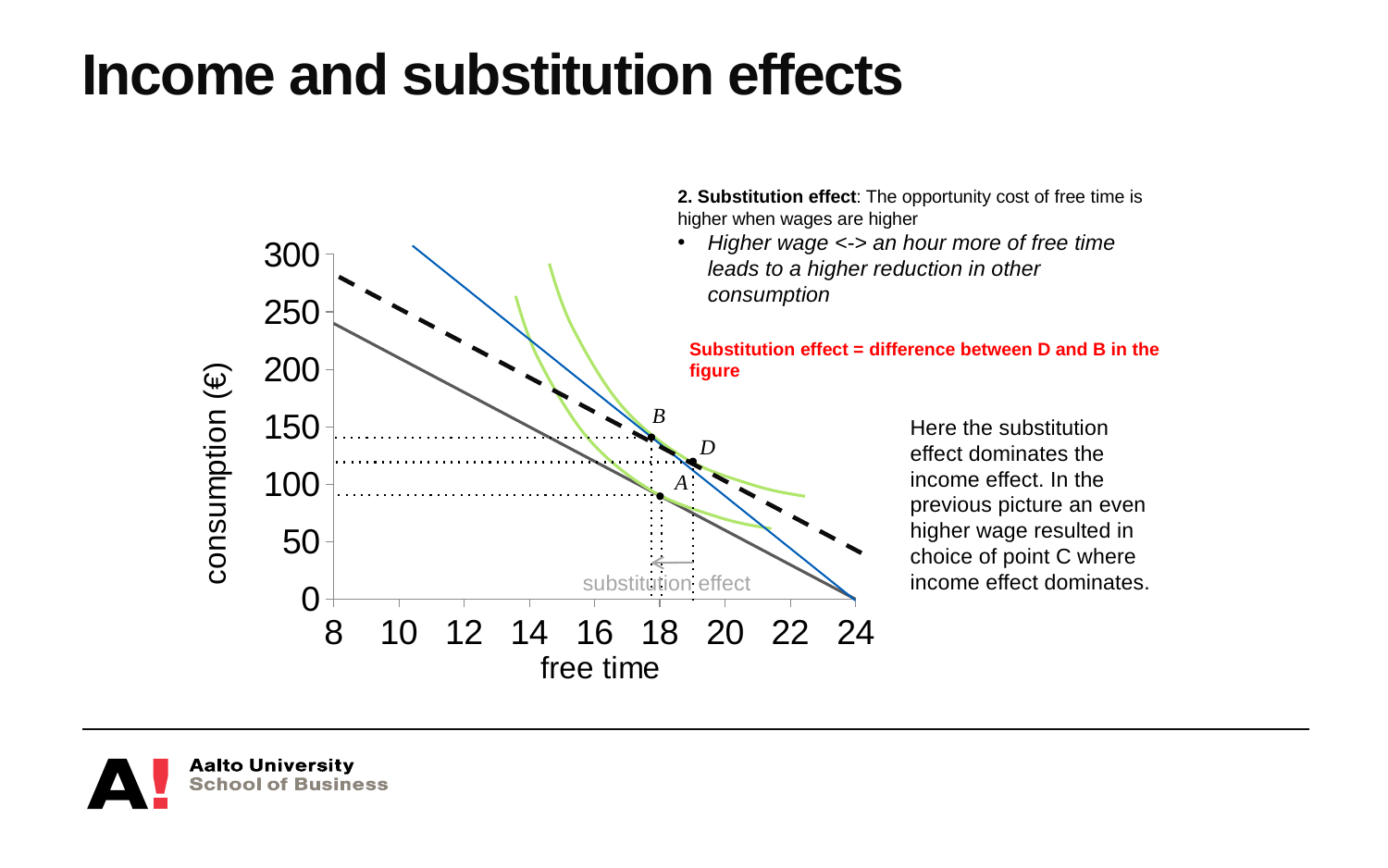
Which labeled point has the highest consumption, A, B or D? B Do the budget lines rise or fall as free time increases along the x axis? fall At what value of free time do the blue and grey budget lines meet the x axis? 24 Which point has more free time, A or D? D Which labeled point has the lowest consumption, A, B or D? A Is the consumption at point B greater or less than 100? greater What is the label of the x axis of the chart? free time What is the label of the y axis of the chart? consumption (€) Is the consumption at point D greater or less than 150? less How many labeled points (A, B, D) are marked on the chart? 3 Is the consumption at point A greater or less than 100? less What kind of chart is shown on the slide? line chart